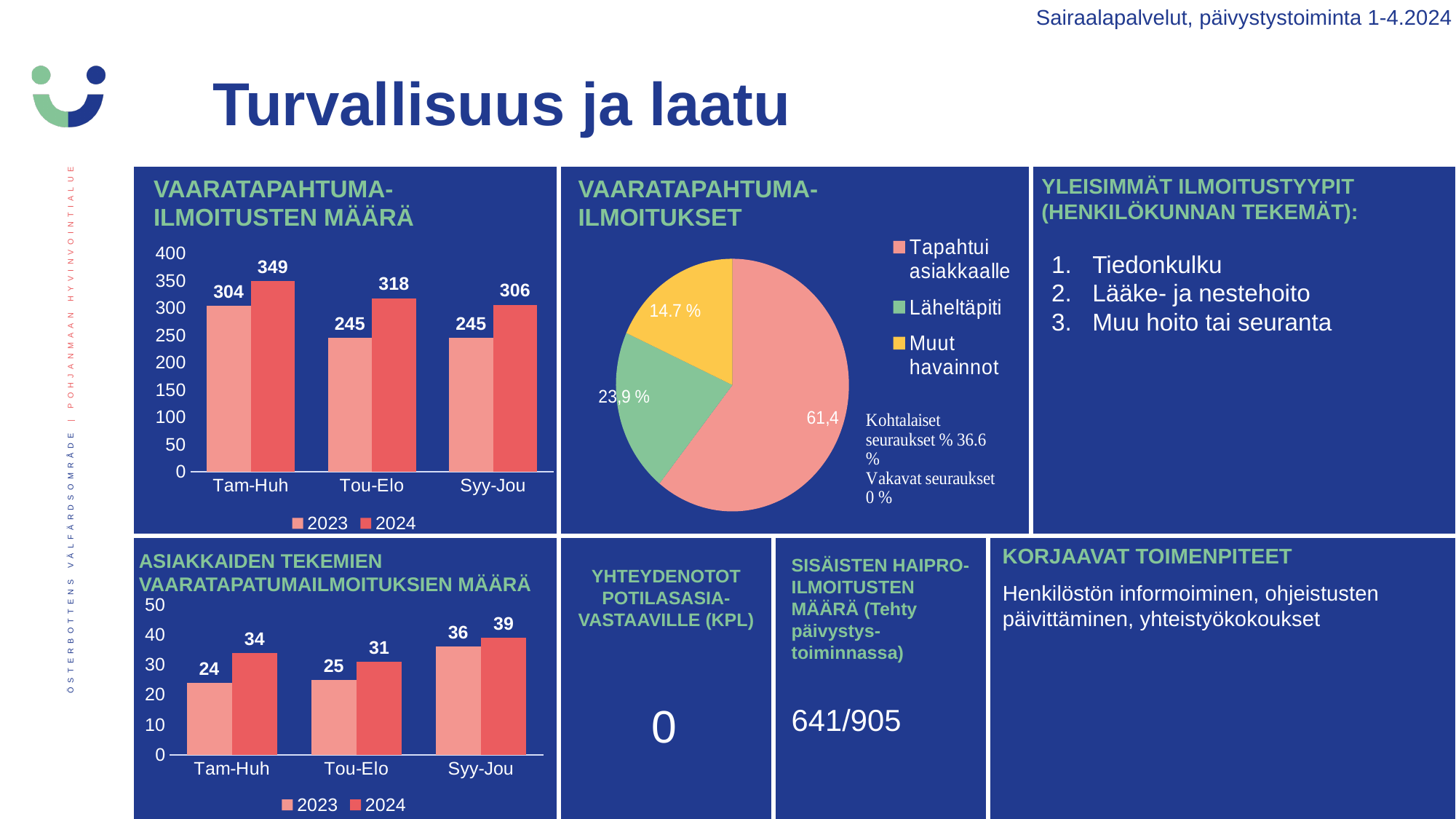
In the pie chart titled VAARATAPAHTUMA-ILMOITUKSET, what share is shown for Muut havainnot? 14.7 % In the chart titled VAARATAPAHTUMA-ILMOITUSTEN MÄÄRÄ, what is the difference between the 2024 and 2023 values in Syy-Jou? 61 In the chart titled ASIAKKAIDEN TEKEMIEN VAARATAPATUMAILMOITUKSIEN MÄÄRÄ, which period has the lowest 2023 value? Tam-Huh In the chart titled VAARATAPAHTUMA-ILMOITUSTEN MÄÄRÄ, how many series does the legend list? 2 In the chart titled VAARATAPAHTUMA-ILMOITUSTEN MÄÄRÄ, what is the value for 2023 in Tou-Elo? 245 In the pie chart titled VAARATAPAHTUMA-ILMOITUKSET, which category has the largest slice? Tapahtui asiakkaalle In the chart titled VAARATAPAHTUMA-ILMOITUSTEN MÄÄRÄ, which period has the highest 2024 value? Tam-Huh In the chart titled ASIAKKAIDEN TEKEMIEN VAARATAPATUMAILMOITUKSIEN MÄÄRÄ, how many periods are shown on the x axis? 3 In the pie chart titled VAARATAPAHTUMA-ILMOITUKSET, what share is shown for Läheltäpiti? 23,9 % In the chart titled VAARATAPAHTUMA-ILMOITUSTEN MÄÄRÄ, what is the value for 2024 in Tam-Huh? 349 In the chart titled ASIAKKAIDEN TEKEMIEN VAARATAPATUMAILMOITUKSIEN MÄÄRÄ, what is the value for 2024 in Syy-Jou? 39 In the chart titled VAARATAPAHTUMA-ILMOITUSTEN MÄÄRÄ, what kind of chart is shown? bar chart